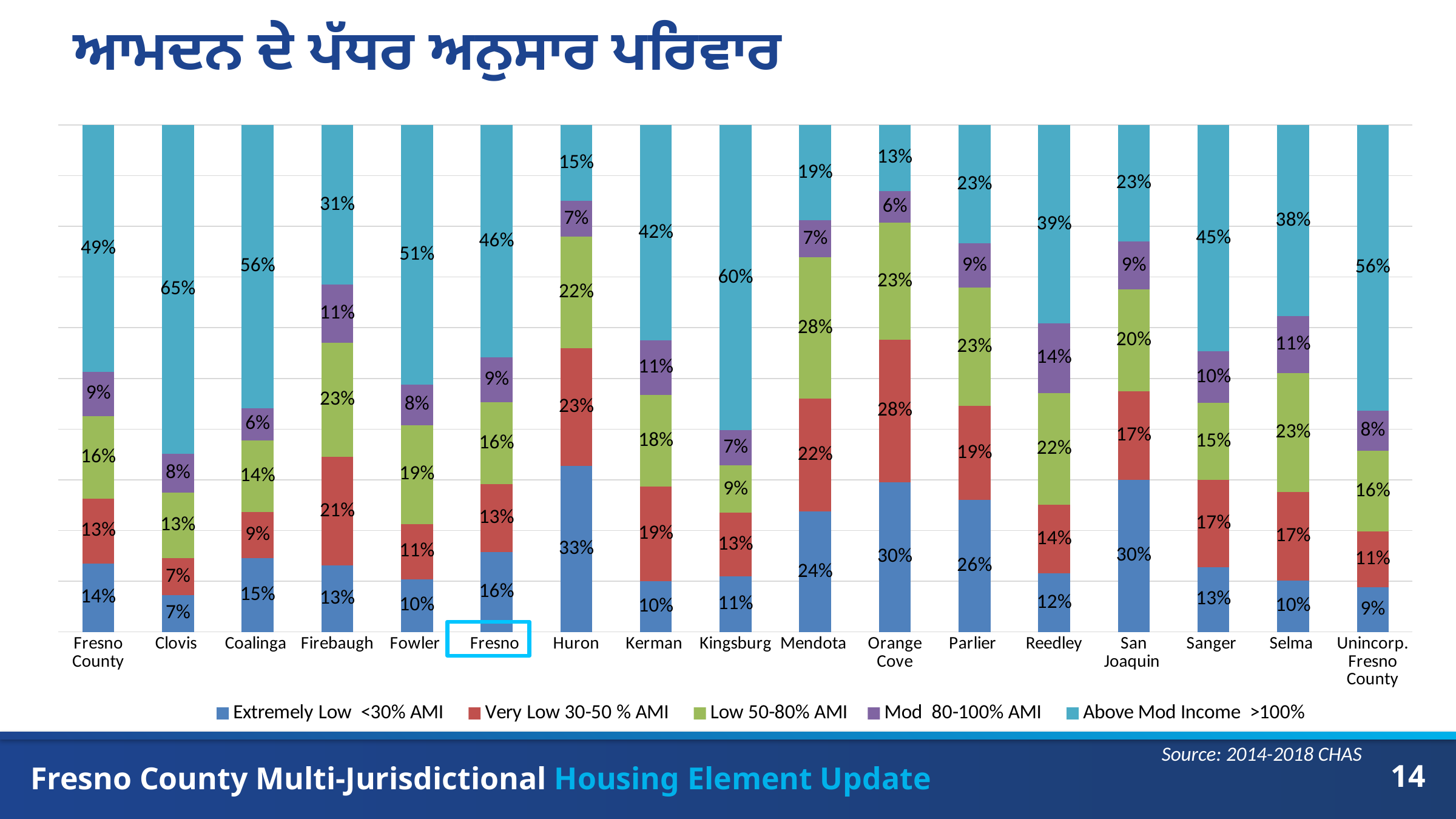
How many series does the legend list? 5 What is the Extremely Low <30% AMI share for Huron? 33% What is the Above Mod Income >100% share for Clovis? 65% Which x-axis label is highlighted with a box? Fresno What is the Low 50-80% AMI share for Mendota? 28% Which jurisdiction has the lowest Above Mod Income >100% share? Orange Cove What is the difference in percentage points between the Above Mod Income share for Fresno County (49%) and Fresno (46%)? 3 percentage points Which jurisdiction has the highest Above Mod Income >100% share? Clovis How many jurisdictions are shown on the x axis? 17 What kind of chart is shown on the slide? Stacked bar chart Which has a larger Extremely Low <30% AMI share, Mendota or Parlier? Parlier Which jurisdiction has the highest Extremely Low <30% AMI share? Huron